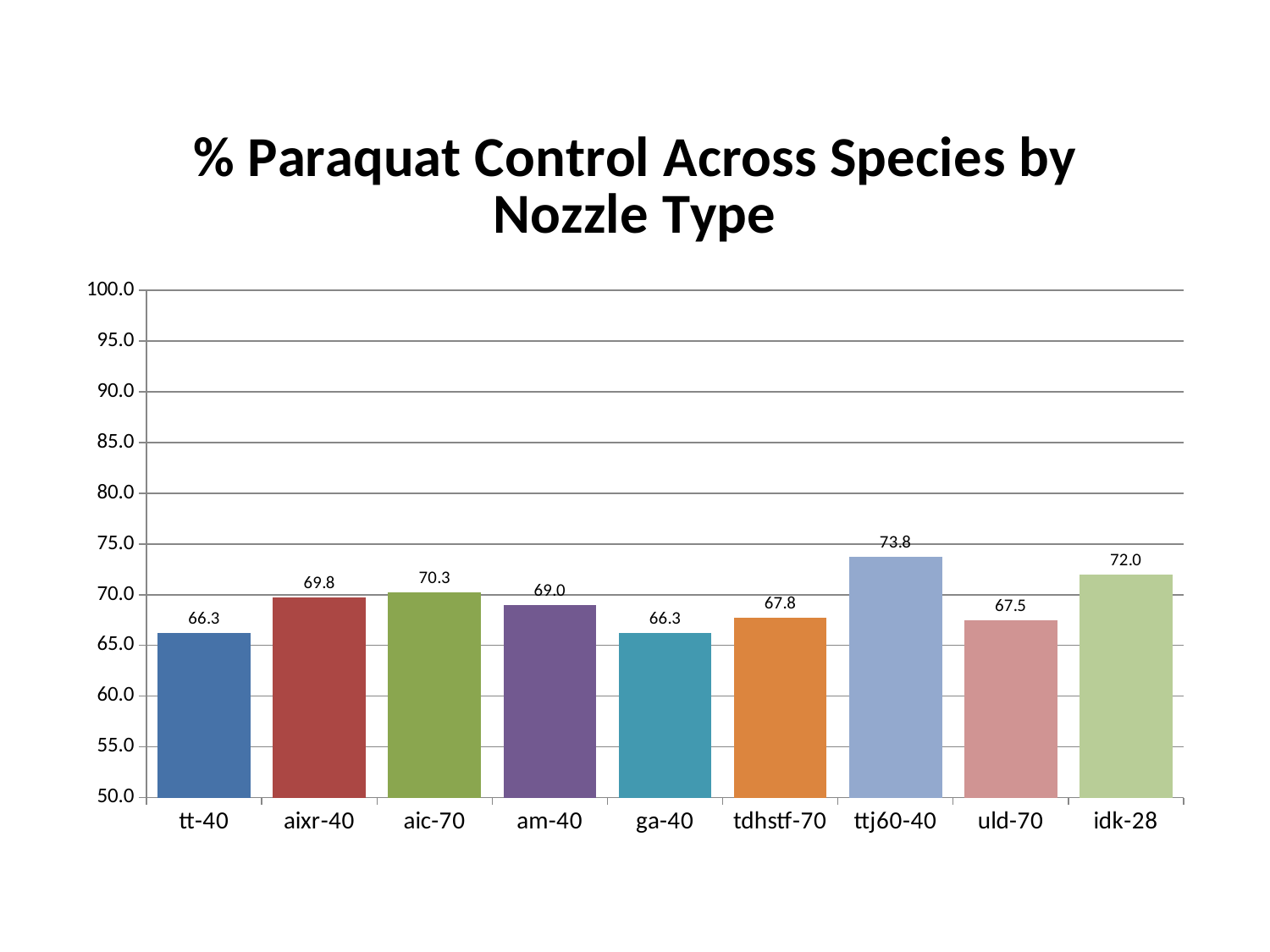
Which is larger, the value for aic-70 or the value for am-40? aic-70 What is the value for aixr-40? 69.8 Is the value for ttj60-40 greater or less than 70.0? greater What is the lowest value shown on the chart? 66.3 What is the value for ttj60-40? 73.8 What is the value for uld-70? 67.5 What is the difference between the values for ttj60-40 and tt-40? 7.5 What is the title of the chart? % Paraquat Control Across Species by Nozzle Type What kind of chart is shown on the slide? bar chart What is the difference between the values for idk-28 and uld-70? 4.5 How many nozzle types are shown on the chart? 9 Which nozzle type has the highest value? ttj60-40